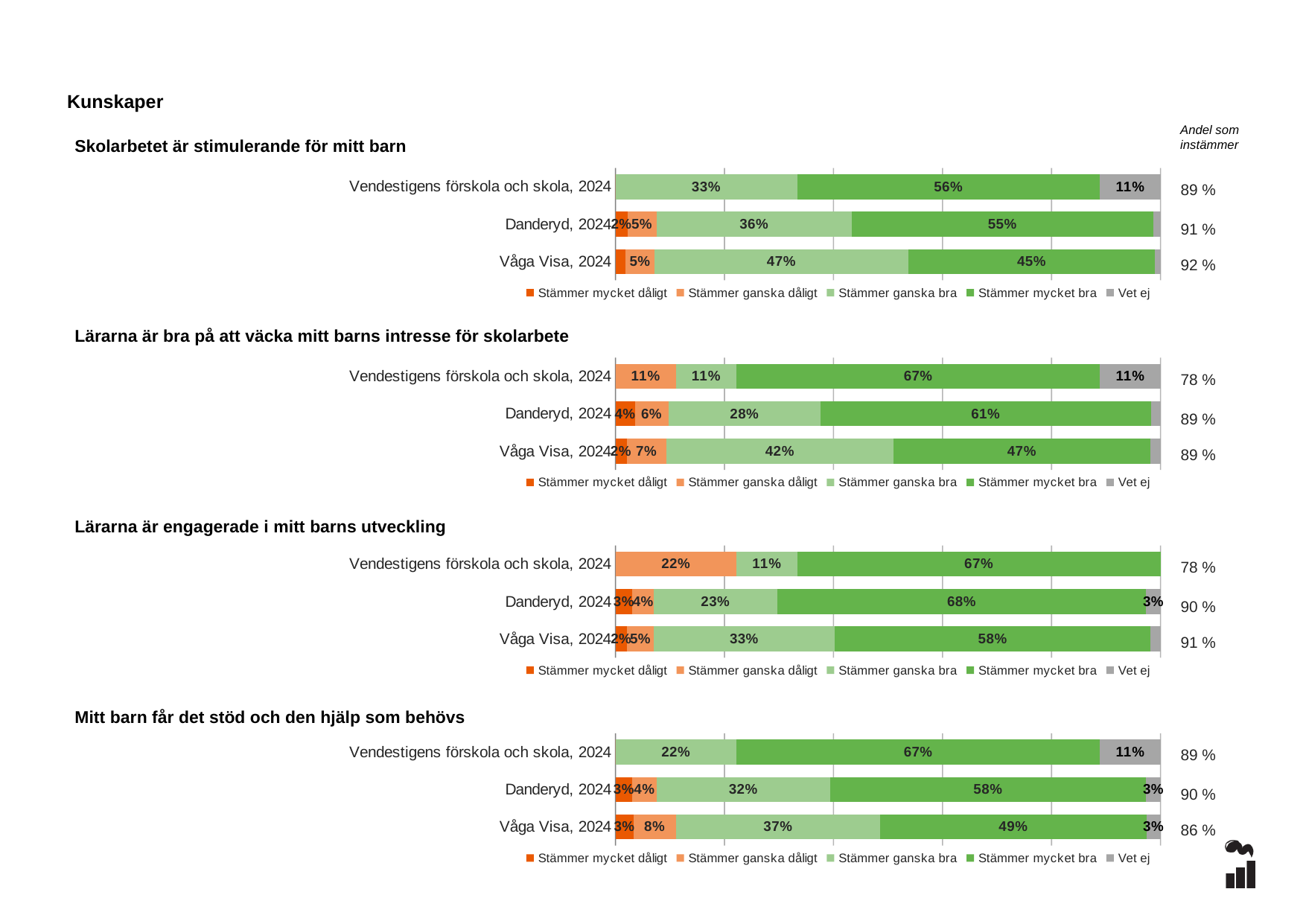
In the chart 'Mitt barn får det stöd och den hjälp som behövs', what is the value of 'Stämmer ganska bra' for Danderyd, 2024? 32% In the chart 'Lärarna är bra på att väcka mitt barns intresse för skolarbete', what is the value of 'Stämmer ganska dåligt' for Vendestigens förskola och skola, 2024? 11% In the chart 'Skolarbetet är stimulerande för mitt barn', what is the value of 'Stämmer mycket bra' for Vendestigens förskola och skola, 2024? 56% In the chart 'Mitt barn får det stöd och den hjälp som behövs', what is the 'Andel som instämmer' value for Våga Visa, 2024? 86 % In the chart 'Lärarna är bra på att väcka mitt barns intresse för skolarbete', which category has the highest 'Stämmer mycket bra' value? Vendestigens förskola och skola, 2024 In the chart 'Lärarna är engagerade i mitt barns utveckling', what is the difference between the 'Stämmer mycket bra' values for Danderyd, 2024 and Våga Visa, 2024? 10% In the chart 'Skolarbetet är stimulerande för mitt barn', what is the value of 'Stämmer ganska bra' for Våga Visa, 2024? 47% How many categories (bars) are shown in the chart 'Skolarbetet är stimulerande för mitt barn'? 3 In the chart 'Lärarna är engagerade i mitt barns utveckling', what is the value of 'Stämmer ganska dåligt' for Vendestigens förskola och skola, 2024? 22% In the chart 'Mitt barn får det stöd och den hjälp som behövs', which is larger: the 'Stämmer mycket bra' value for Vendestigens förskola och skola, 2024 or for Våga Visa, 2024? Vendestigens förskola och skola, 2024 How many series does the legend list in the chart 'Lärarna är engagerade i mitt barns utveckling'? 5 What type of chart is 'Mitt barn får det stöd och den hjälp som behövs'? Stacked bar chart